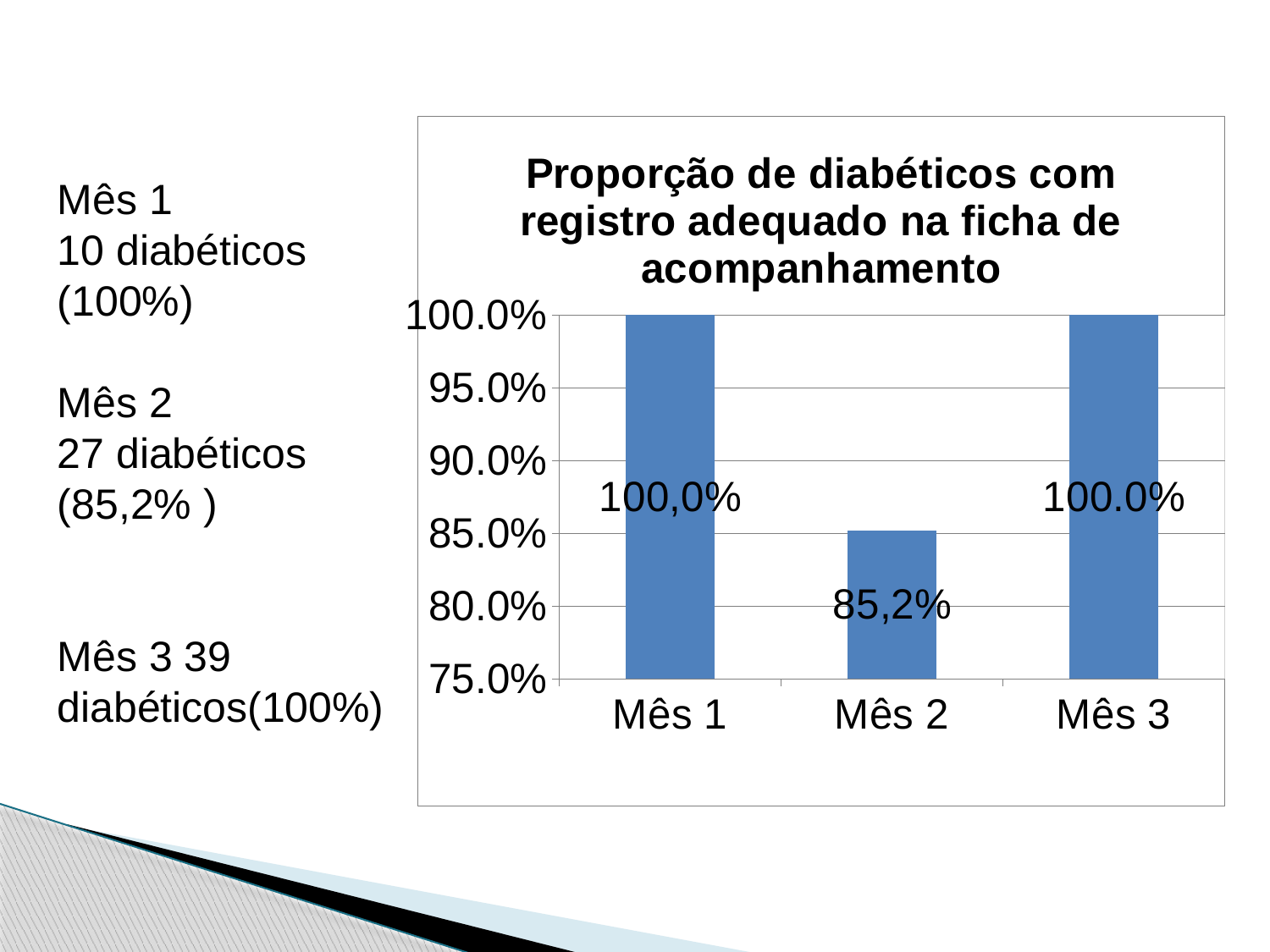
What is the value for Mês 1? 100,0% Is the value for Mês 2 greater or less than 90.0%? less What kind of chart is this? bar chart What is the value for Mês 3? 100.0% Which month has the lowest value? Mês 2 What is the title of the chart? Proporção de diabéticos com registro adequado na ficha de acompanhamento What is the lowest value shown on the y axis? 75.0% What is the value for Mês 2? 85,2% How many months are shown on the x axis? 3 Which is larger, the value for Mês 1 or the value for Mês 2? Mês 1 Is the value for Mês 1 greater or less than 95.0%? greater